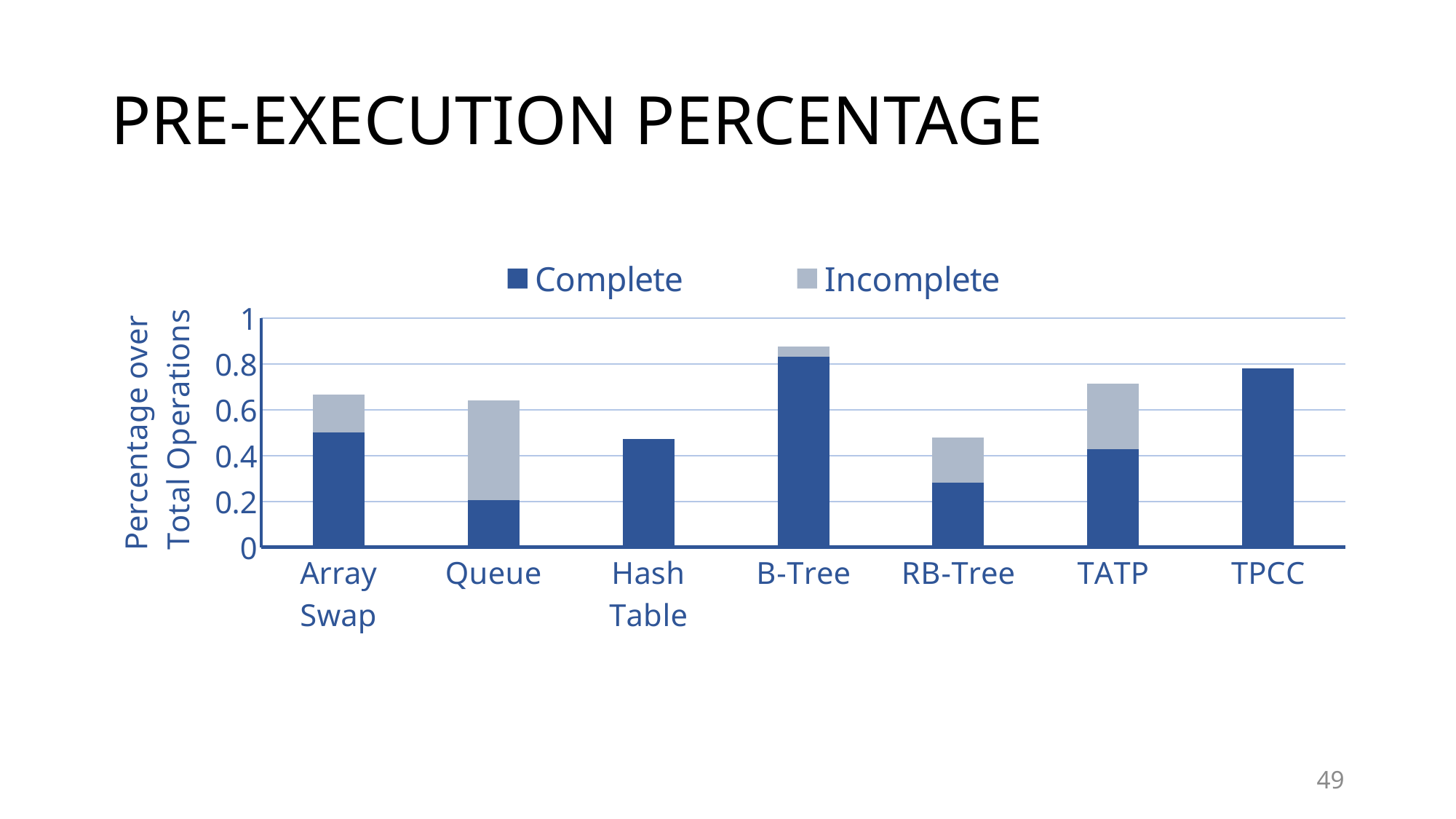
Which category has the lowest Complete value? Queue What is the title of the chart's y axis? Percentage over Total Operations What are the two series named in the chart's legend? Complete and Incomplete How many series does the chart's legend list? 2 Which is larger, the Complete value for TPCC or the Complete value for Hash Table? TPCC Is the Complete value for Queue greater or less than 0.4? less Is the Complete value for Hash Table greater or less than 0.6? less What kind of chart is shown on the slide? bar chart How many categories are shown on the x axis of the chart? 7 Which category has the highest Complete value? B-Tree Is the Complete value for Array Swap greater or less than 0.4? greater Which category has the largest Incomplete segment? Queue